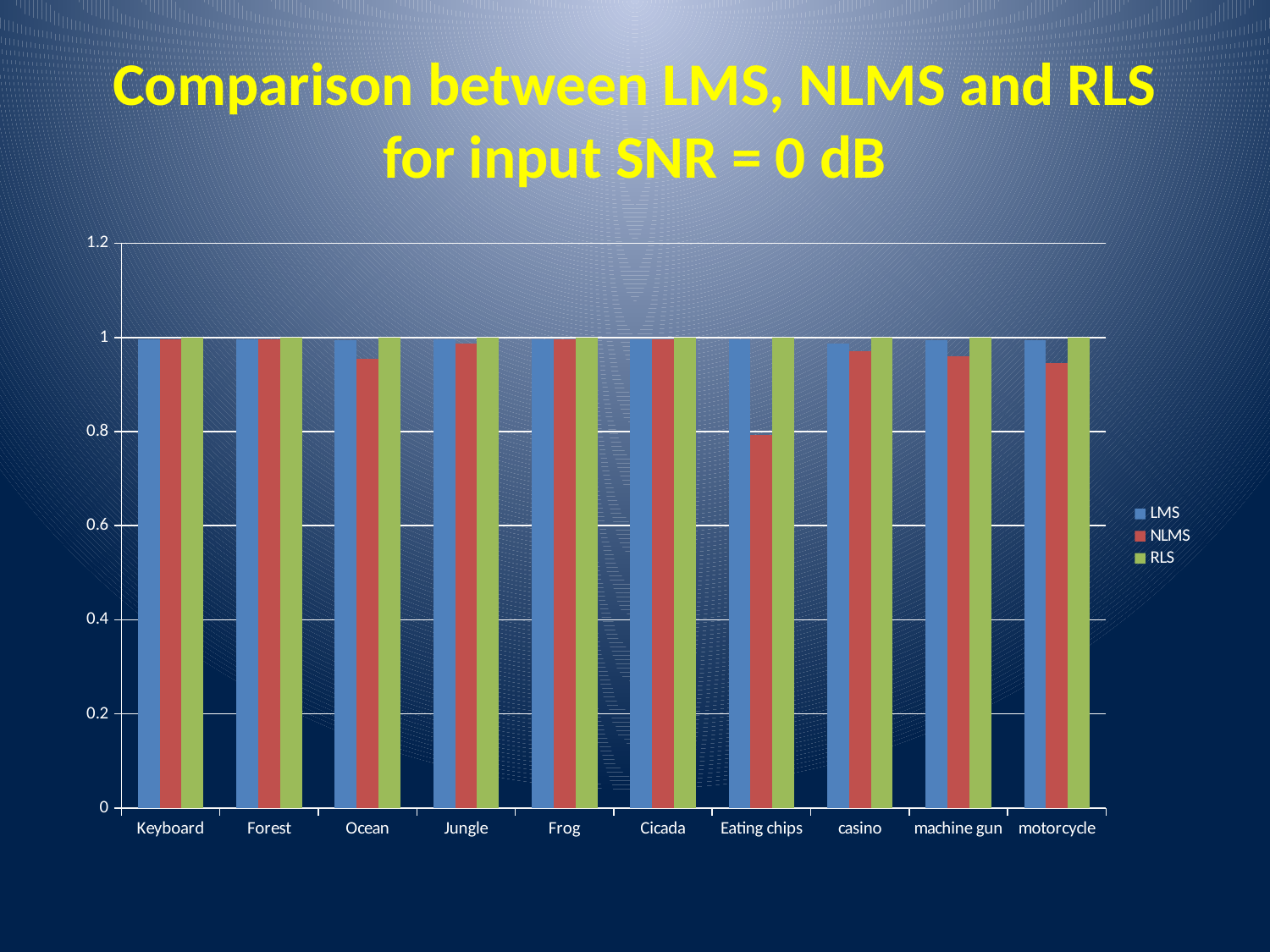
What kind of chart is shown on the slide? bar chart What is the title of the chart's slide? Comparison between LMS, NLMS and RLS for input SNR = 0 dB Which series is shown in green? RLS For motorcycle, which is larger: the LMS value or the NLMS value? LMS Which is larger: the NLMS value for Keyboard or the NLMS value for Ocean? Keyboard For Eating chips, which is larger: the NLMS value or the RLS value? RLS Is the RLS value for Keyboard greater or less than 0.8? greater Is the NLMS value for Eating chips greater or less than 1? less Is the NLMS value for Ocean greater or less than 0.8? greater How many series does the legend list? 3 Which category has the lowest NLMS value? Eating chips How many categories are shown on the x axis? 10